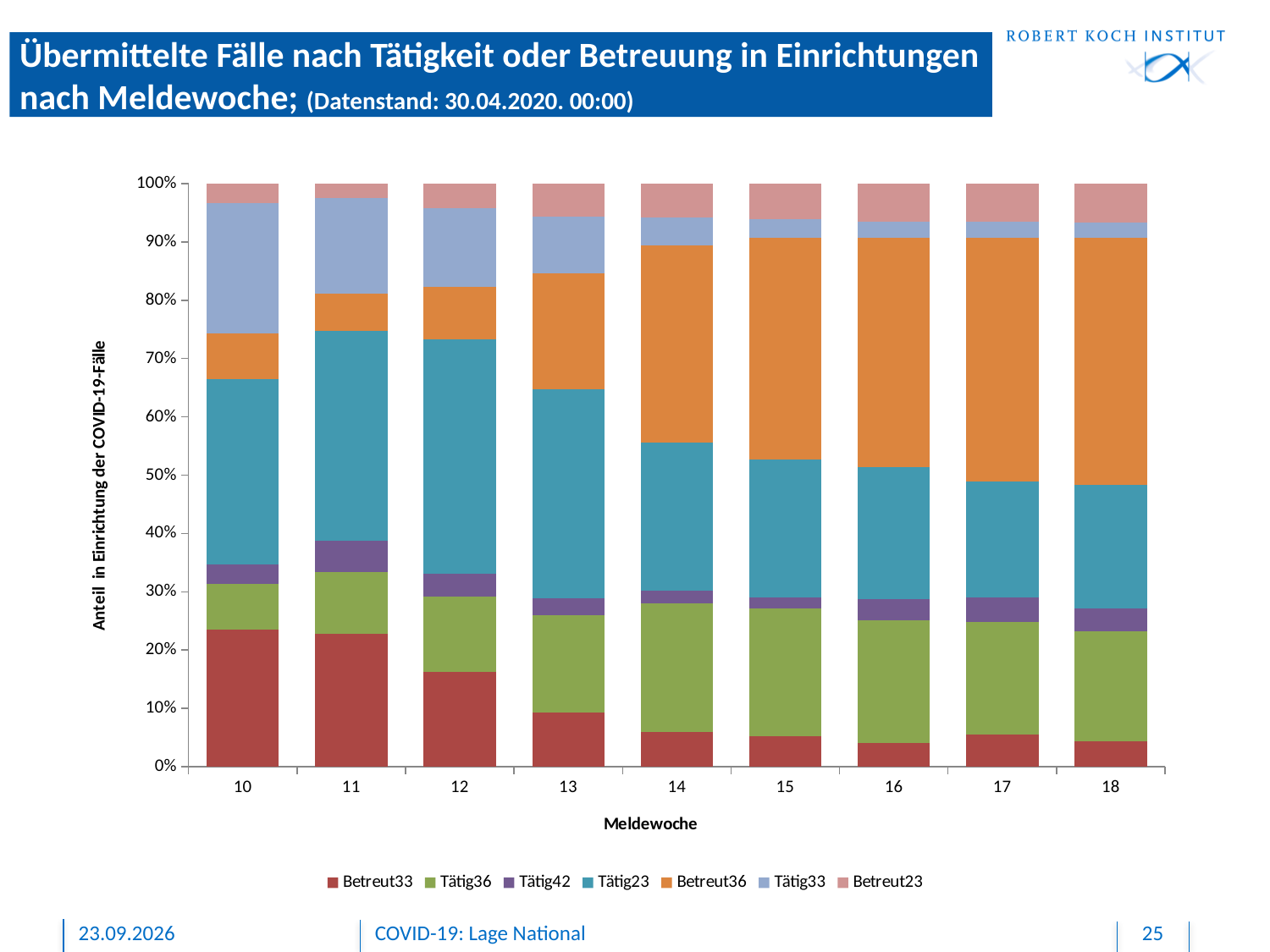
How many Meldewochen (reporting weeks) are shown on the x axis? 9 What kind of chart is shown on the slide? Stacked bar chart Does the Betreut36 share rise or fall from Meldewoche 10 to Meldewoche 18? rise How many series does the legend list? 7 In which Meldewoche is the Tätig33 share the largest? 10 Is the Betreut33 share in Meldewoche 10 greater or less than 20%? greater In which Meldewoche is the Tätig23 share the largest? 12 What is the title of the x axis? Meldewoche Is the Tätig36 share larger in Meldewoche 14 or in Meldewoche 10? Meldewoche 14 Is the Betreut36 share in Meldewoche 10 greater or less than 10%? less Does the Betreut33 share rise or fall from Meldewoche 10 to Meldewoche 18? fall Is the Betreut33 share in Meldewoche 18 greater or less than 10%? less